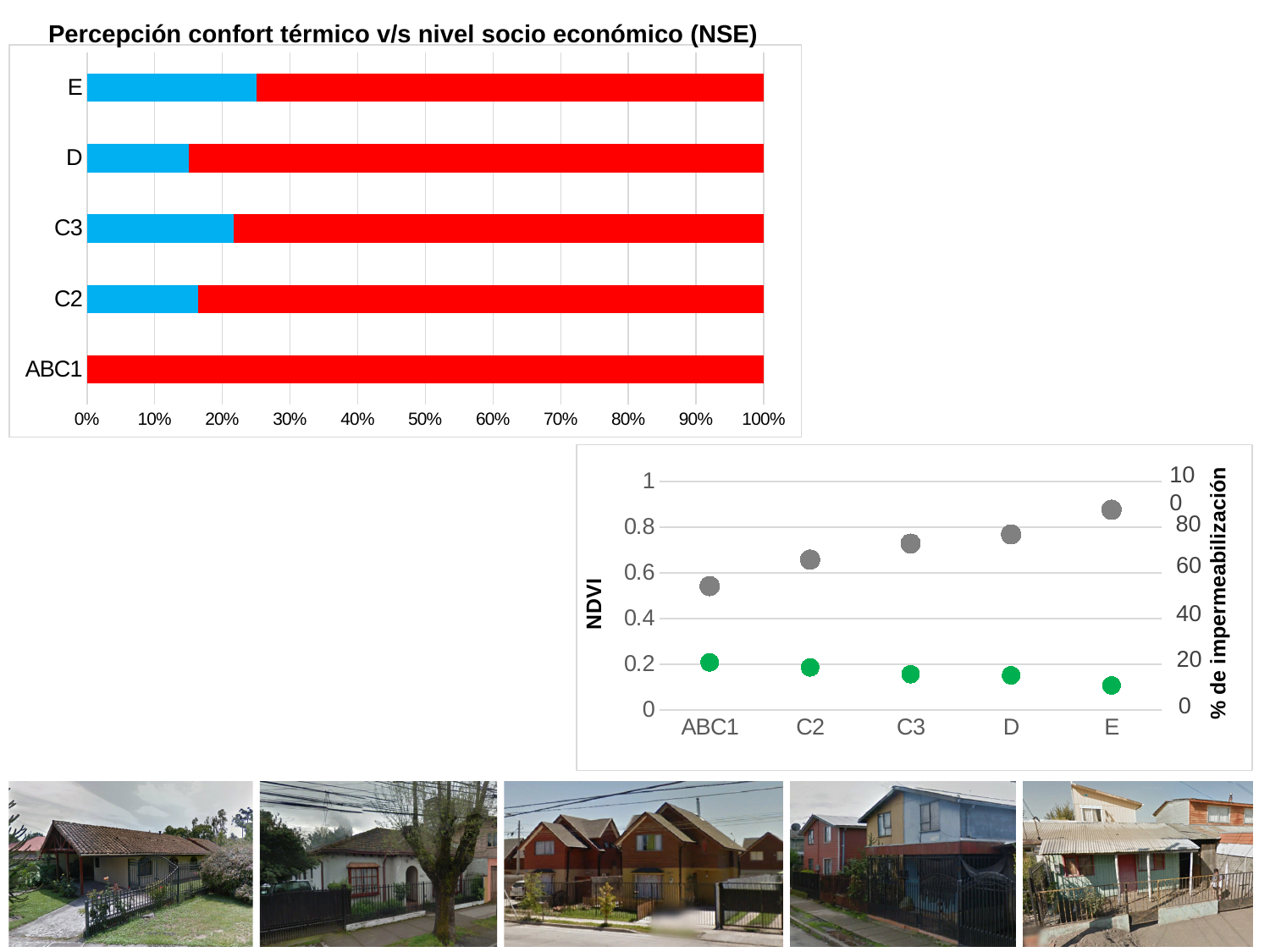
In the dot chart on the right with the NDVI axis, how many categories are shown on the x axis? 5 In the chart 'Percepción confort térmico v/s nivel socio económico (NSE)', is the blue segment for D greater or less than 20%? less In the chart 'Percepción confort térmico v/s nivel socio económico (NSE)', what kind of chart is shown? bar chart In the dot chart on the right with the NDVI axis, is the green (NDVI) value for E greater or less than 0.2? less In the chart 'Percepción confort térmico v/s nivel socio económico (NSE)', which category has no blue segment at all? ABC1 In the chart 'Percepción confort térmico v/s nivel socio económico (NSE)', how many socio-economic categories are plotted? 5 In the dot chart on the right with the NDVI axis, do the grey points rise or fall from ABC1 to E? rise In the chart 'Percepción confort térmico v/s nivel socio económico (NSE)', which has the larger blue segment, E or C2? E What is the title of the bar chart at the top of the slide? Percepción confort térmico v/s nivel socio económico (NSE) In the chart 'Percepción confort térmico v/s nivel socio económico (NSE)', which category has the largest blue segment? E In the dot chart on the right with the NDVI axis, which category has the lowest green (NDVI) point? E In the chart 'Percepción confort térmico v/s nivel socio económico (NSE)', is the blue segment for E greater or less than 20%? greater